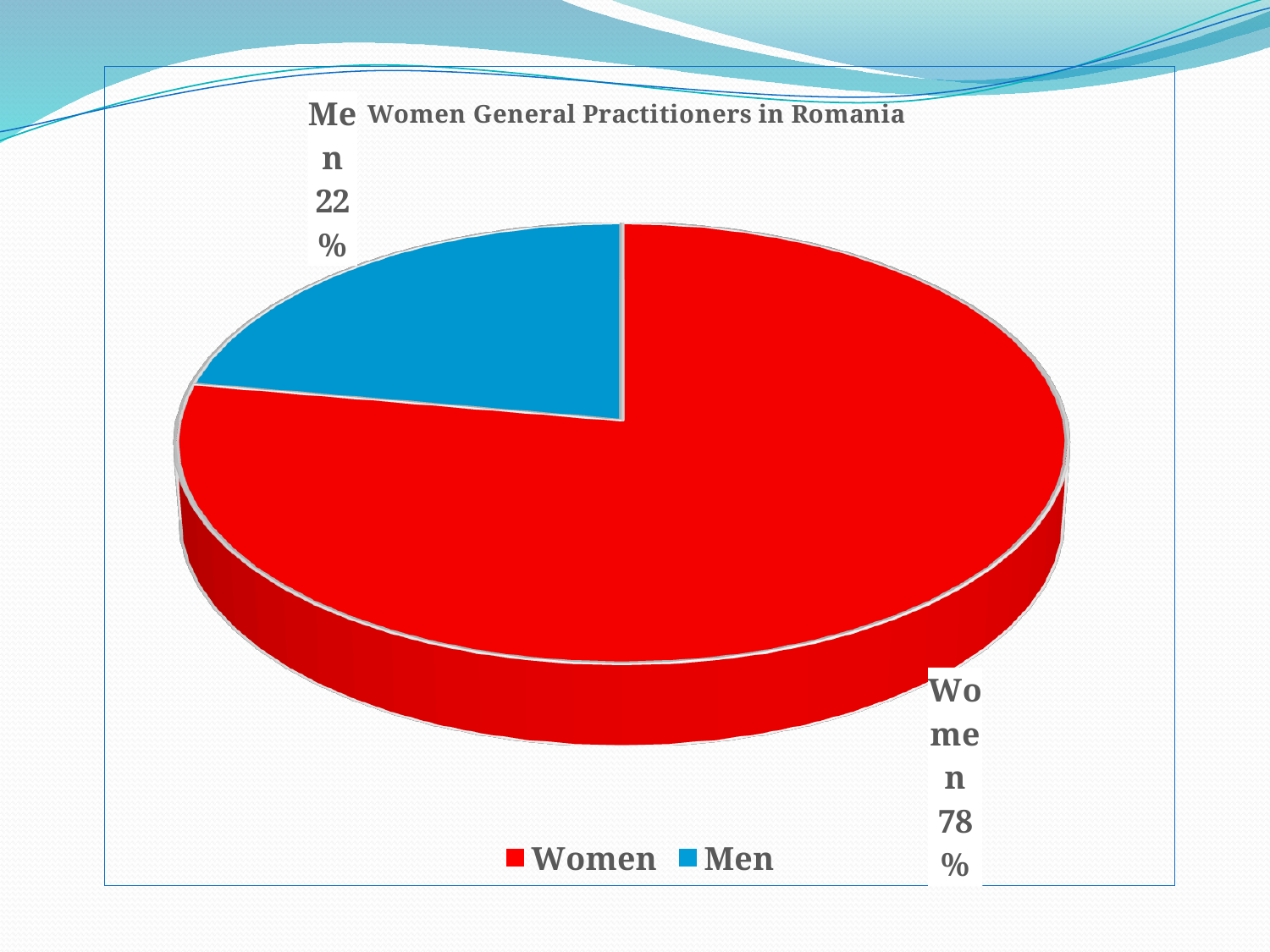
What share of the pie is labelled for Men? 22% Which category has the smallest slice of the pie? Men How many slices does the pie chart have? 2 Which slice is larger, Women or Men? Women What kind of chart is shown on the slide? pie chart What colour is the Men slice? blue How many entries does the legend list? 2 What is the difference in percentage points between the Women and Men slices? 56 What share of the pie is labelled for Women? 78% Which category has the largest slice of the pie? Women What is the title of the pie chart? Women General Practitioners in Romania